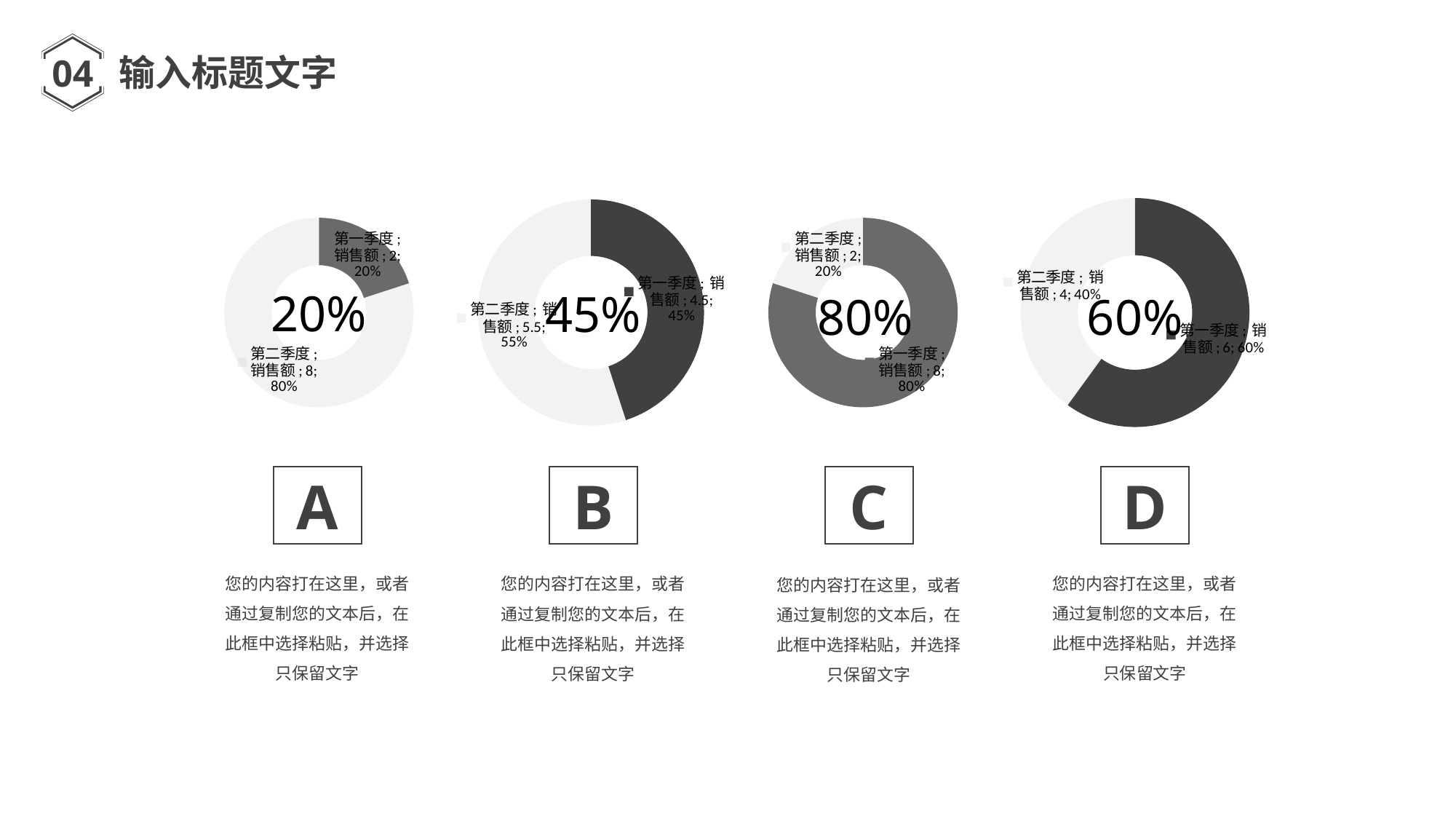
In the third doughnut chart from the left (above the letter C), what is the value for 第一季度 销售额? 8 In the rightmost doughnut chart (above the letter D), which quarter has the largest value? 第一季度 In the rightmost doughnut chart (above the letter D), what is the total of the two values? 10 In the rightmost doughnut chart (above the letter D), what is the value for 第二季度 销售额? 4 In the second doughnut chart from the left (above the letter B), what share of the chart does 第一季度 represent? 45% What kind of chart is shown above the letter C? Doughnut chart In the leftmost doughnut chart (above the letter A), what share of the chart does 第二季度 represent? 80% In the leftmost doughnut chart (above the letter A), what is the value for 第一季度 销售额? 2 In the second doughnut chart from the left (above the letter B), what is the value for 第二季度 销售额? 5.5 In the third doughnut chart from the left (above the letter C), what is the difference between the 第一季度 and 第二季度 values? 6 How many categories (slices) does the leftmost doughnut chart (above the letter A) have? 2 In the second doughnut chart from the left (above the letter B), which quarter has the larger value, 第一季度 or 第二季度? 第二季度